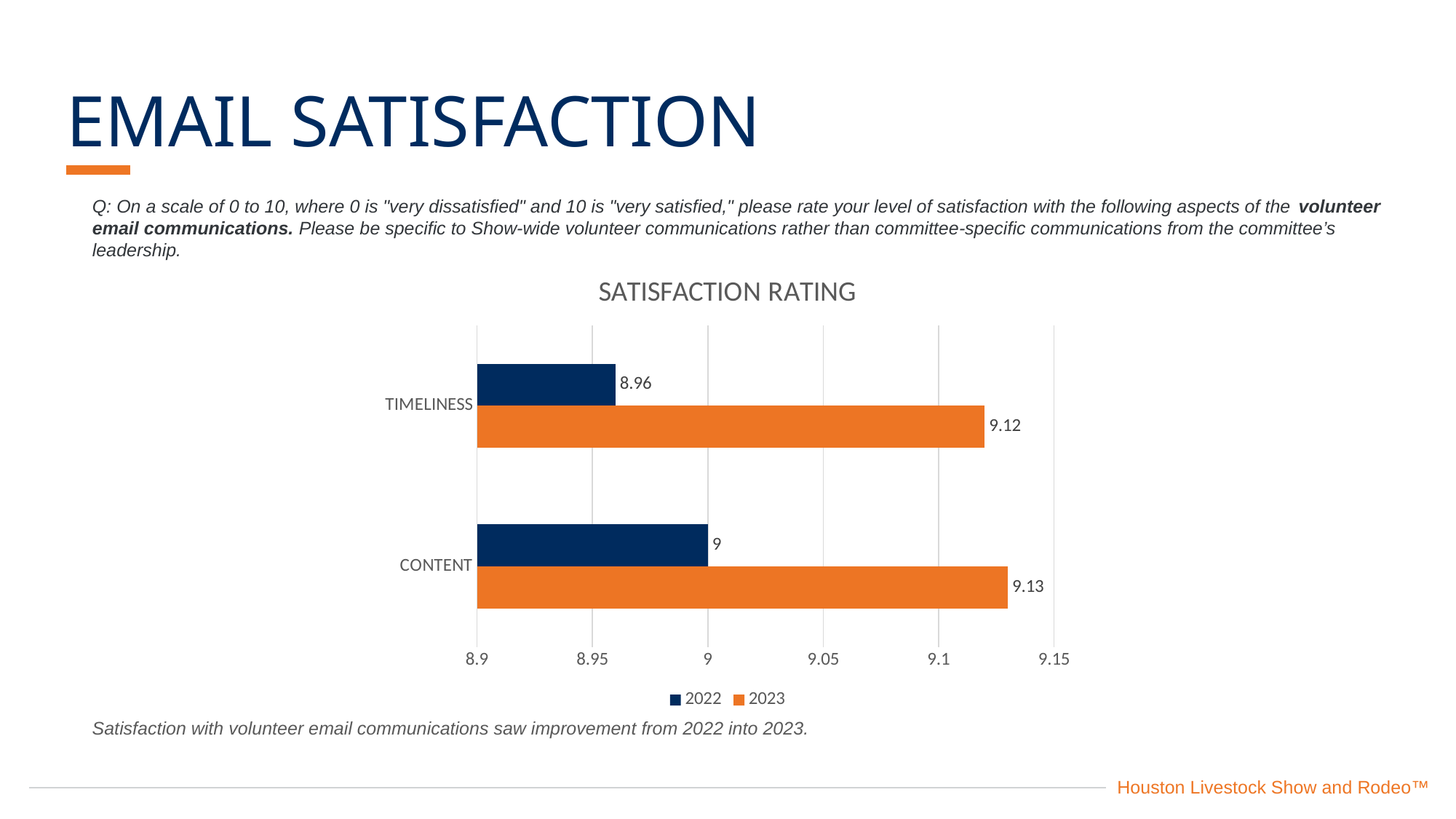
What type of chart is shown on the slide? Bar chart What is the difference between the 2023 and 2022 ratings for Timeliness? 0.16 How many categories are shown on the chart? 2 What is the difference between the 2023 and 2022 ratings for Content? 0.13 Which category has the lowest 2022 rating? Timeliness What is the 2023 satisfaction rating for Content? 9.13 How many series does the legend list? 2 Which is larger, the 2022 rating for Content or the 2022 rating for Timeliness? 2022 rating for Content What is the 2023 satisfaction rating for Timeliness? 9.12 What is the 2022 satisfaction rating for Timeliness? 8.96 Is the 2023 rating for Timeliness greater or less than 9.05? greater What is the 2022 satisfaction rating for Content? 9